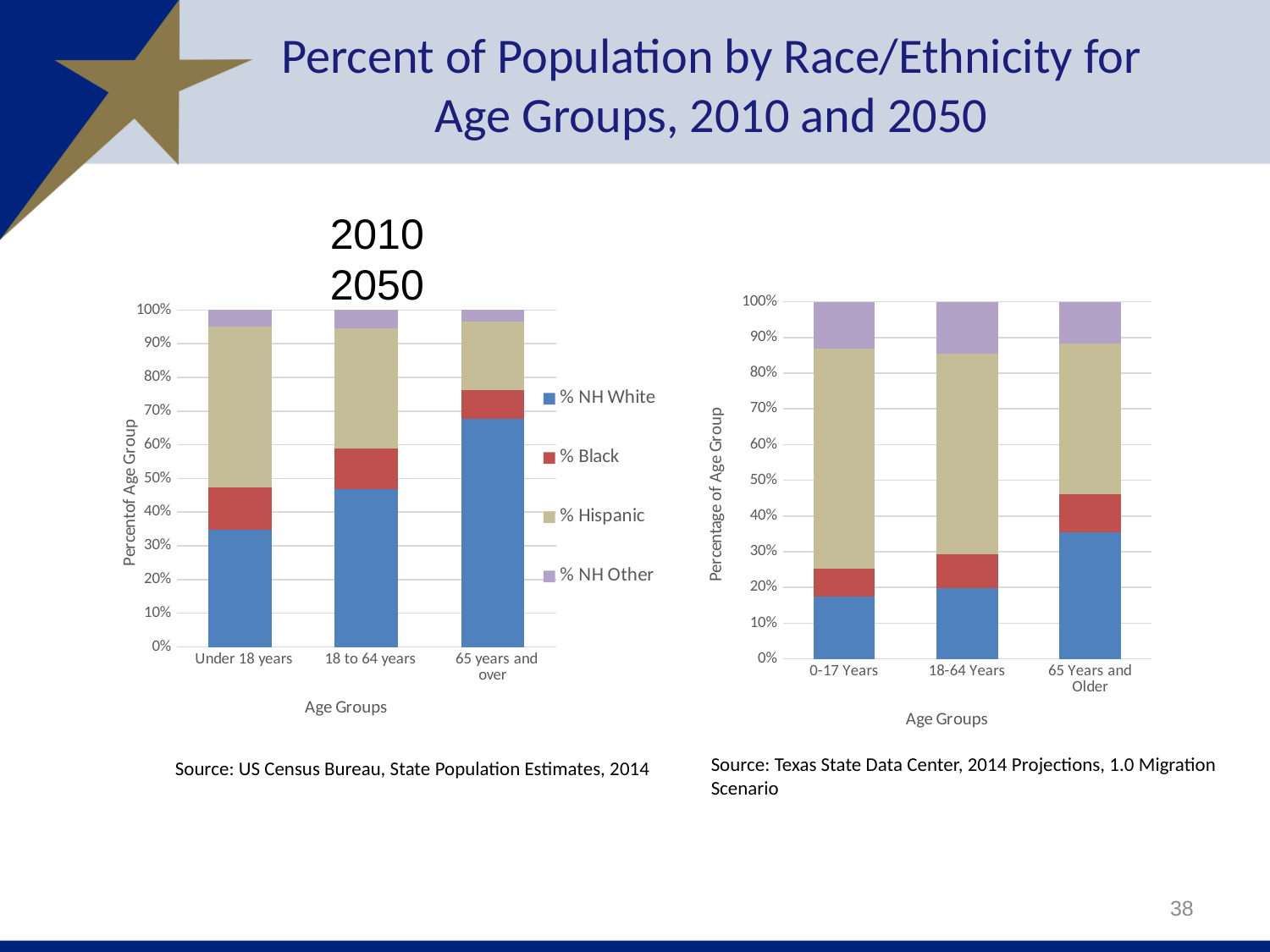
In the right chart, is the % NH White value for 65 Years and Older greater or less than 30%? greater In the right chart, is the % NH White share larger for 0-17 Years or for 65 Years and Older? 65 Years and Older In the left chart, does the % NH White share rise or fall as the age groups move from Under 18 years to 65 years and over? Rise How many age groups are shown on the x axis of the left chart? 3 In the left chart, which age group has the largest % NH White share? 65 years and over In the left chart, is the % NH White value for Under 18 years greater or less than 40%? less What kind of chart is the left chart on the slide? Stacked bar chart In the left chart, is the % NH White value for 65 years and over greater or less than 60%? greater How many series does the legend of the left chart list? 4 What is the y-axis title of the right chart? Percentage of Age Group What is the x-axis title of the right chart? Age Groups